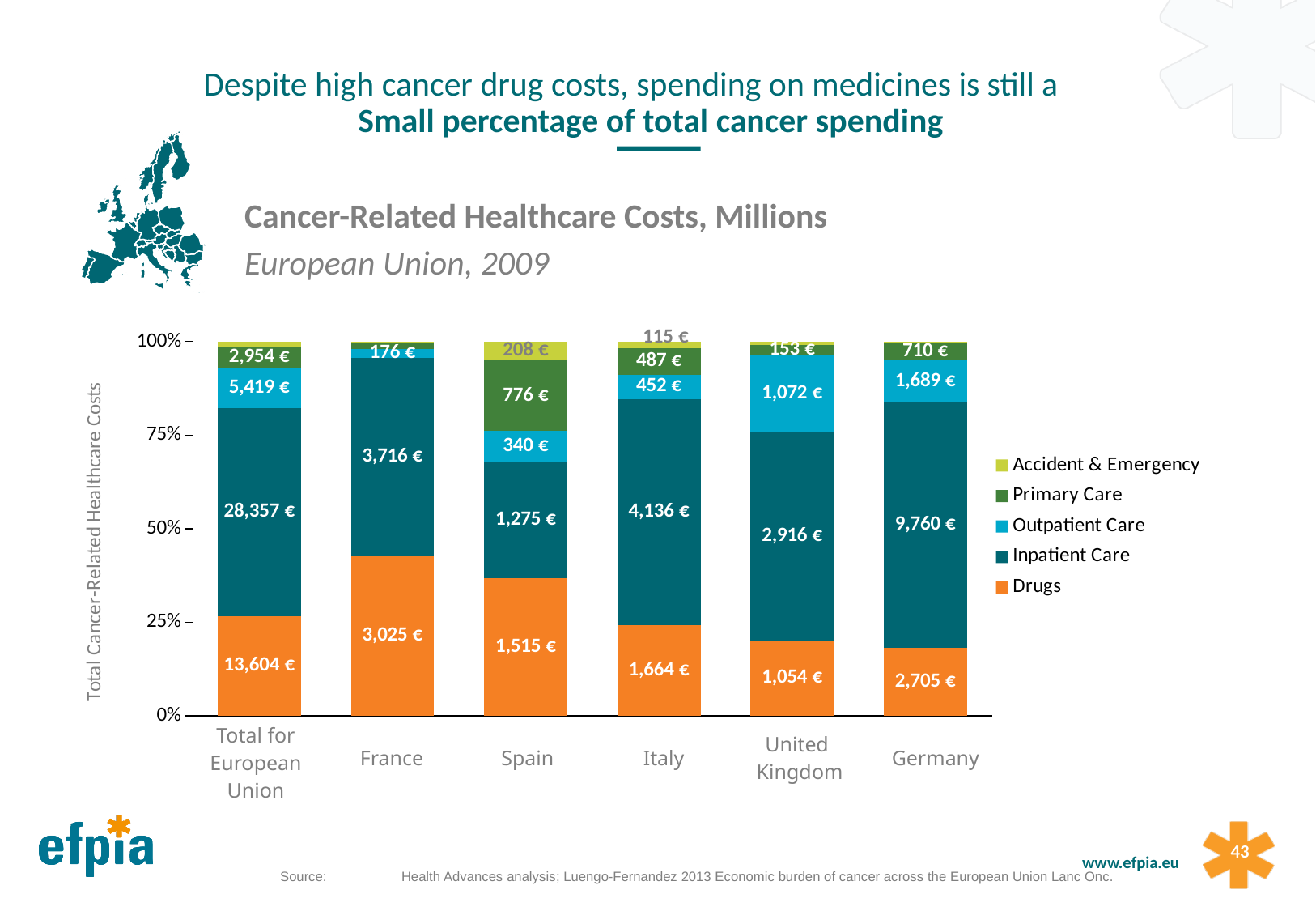
What is the Primary Care value for Spain? 776 € What is the Drugs value for the Total for European Union bar? 13,604 € What type of chart is shown on the slide? Stacked bar chart Which country has the highest Drugs value among the individual countries shown? France How many categories are shown along the x axis? 6 Is the Drugs share of the France bar greater or less than 25%? greater How many series does the legend list? 5 What is the Inpatient Care value for Germany? 9,760 € Which is larger, the Drugs value for Spain or the Drugs value for Italy? Italy What is the difference between the Inpatient Care value for Italy and the Inpatient Care value for Spain? 2,861 € Which legend entry is shown in orange? Drugs What is the Outpatient Care value for the United Kingdom? 1,072 €